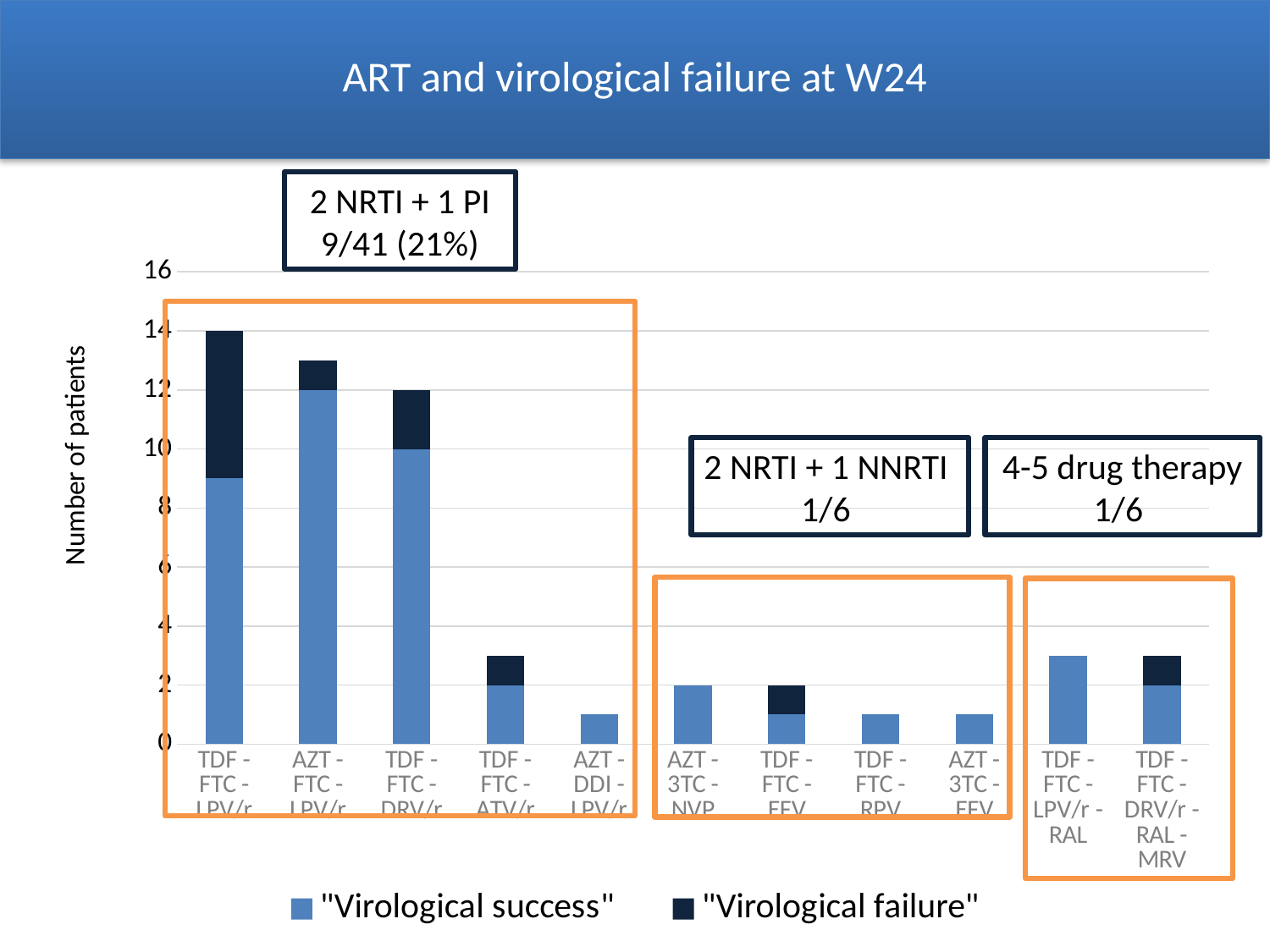
How many series does the legend list? 2 How many patients had virological success on TDF - FTC - DRV/r? 10 What type of chart is shown on the slide? Stacked bar chart How many patients had virological success on AZT - FTC - LPV/r? 12 Is the total number of patients for TDF - FTC - ATV/r greater or less than 4? less What is the total number of patients for the TDF - FTC - DRV/r regimen? 12 Is the total number of patients for AZT - FTC - LPV/r greater or less than 12? greater Which regimen has the highest total number of patients? TDF - FTC - LPV/r How many ART regimen categories are plotted on the x axis? 11 Which regimen has more patients in total, TDF - FTC - DRV/r or TDF - FTC - ATV/r? TDF - FTC - DRV/r What is the title of the slide's chart? ART and virological failure at W24 What is the total number of patients for the TDF - FTC - LPV/r regimen? 14